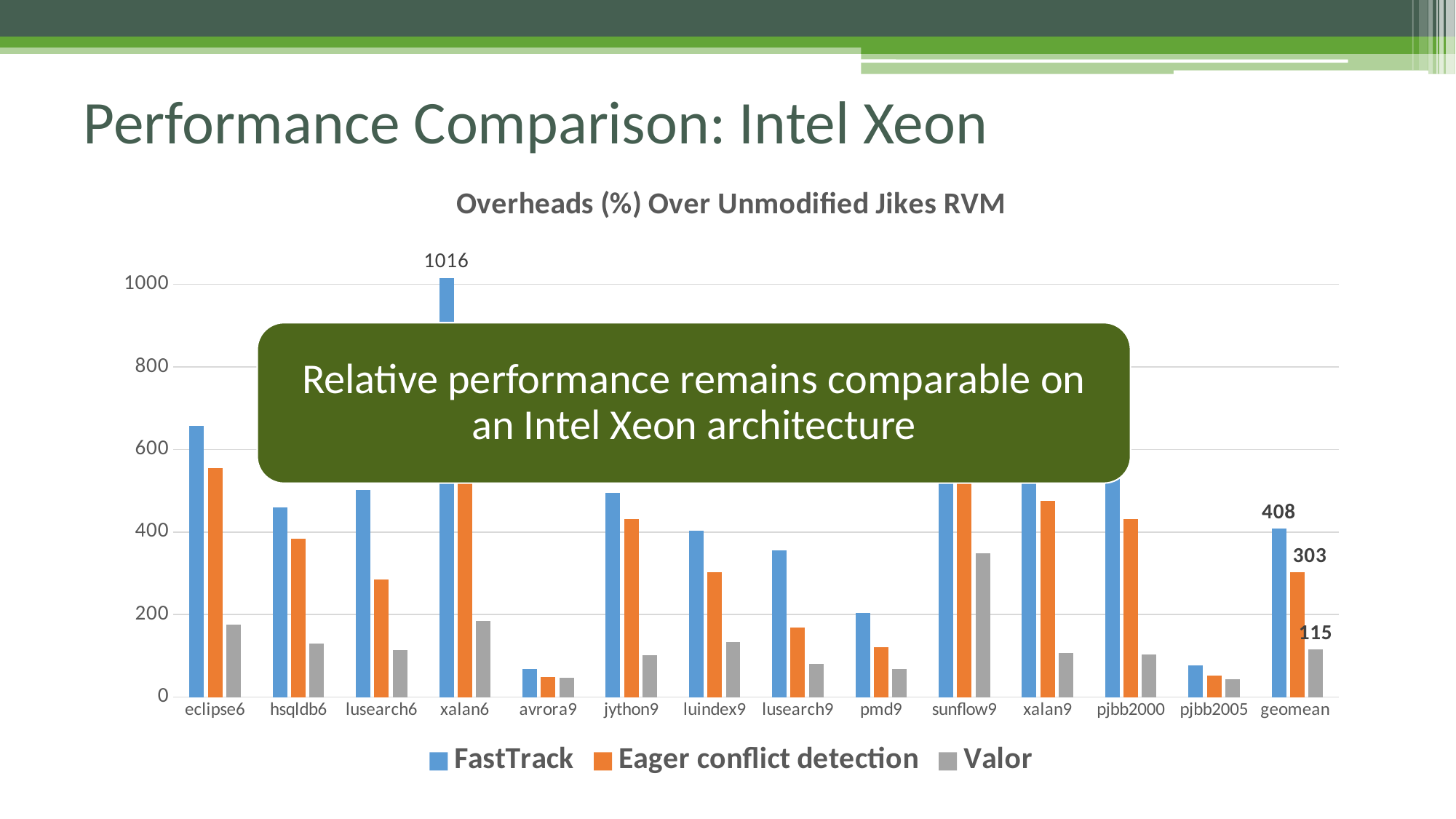
Which benchmark has the highest FastTrack overhead? xalan6 Is the FastTrack value for avrora9 greater or less than 200? less What is the FastTrack overhead value for xalan6? 1016 For eclipse6, which is larger: the FastTrack value or the Eager conflict detection value? FastTrack What is the FastTrack value for geomean? 408 How many series does the legend list? 3 How many benchmark categories are shown on the x axis? 14 What is the difference between the FastTrack and Valor values for geomean? 293 What is the Valor value for geomean? 115 Which benchmark has the highest Valor overhead? sunflow9 Is the Valor value for sunflow9 greater or less than 200? greater What is the Eager conflict detection value for geomean? 303